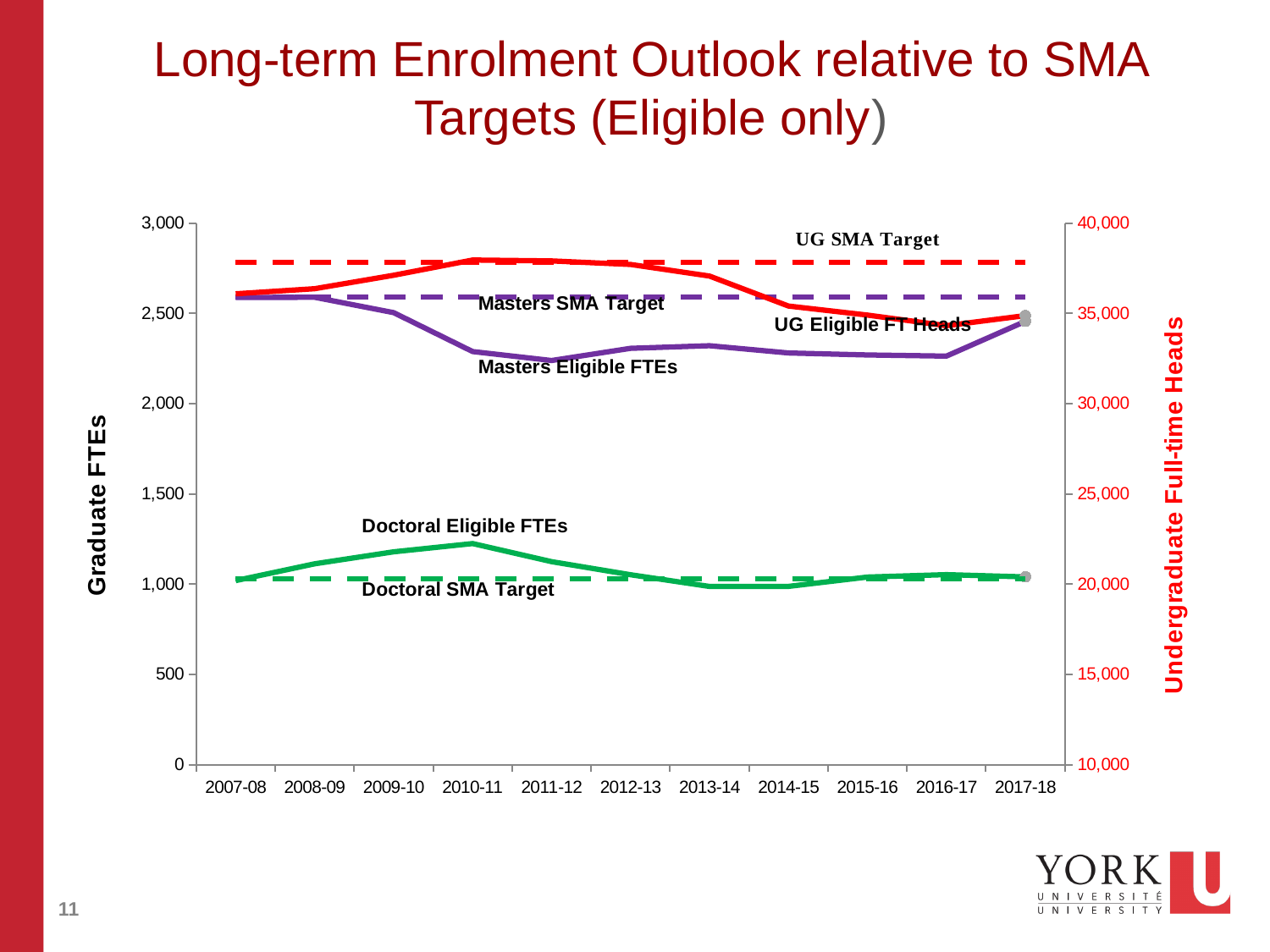
How many academic years are shown along the x axis? 11 Is the value for Doctoral Eligible FTEs in 2010-11 greater or less than 1,000? greater Is the value for Masters Eligible FTEs in 2007-08 greater or less than 2,500? greater What kind of chart is shown on the slide? Line chart What is the title of the left vertical axis? Graduate FTEs In 2013-14, which is larger: Masters Eligible FTEs or the Masters SMA Target? Masters SMA Target Do UG Eligible FT Heads rise or fall from 2011-12 to 2014-15? fall In which year do Doctoral Eligible FTEs reach their highest value? 2010-11 Is the value for UG Eligible FT Heads in 2010-11 greater or less than 35,000? greater Do Masters Eligible FTEs rise or fall from 2008-09 to 2011-12? fall What is the title of the right vertical axis? Undergraduate Full-time Heads